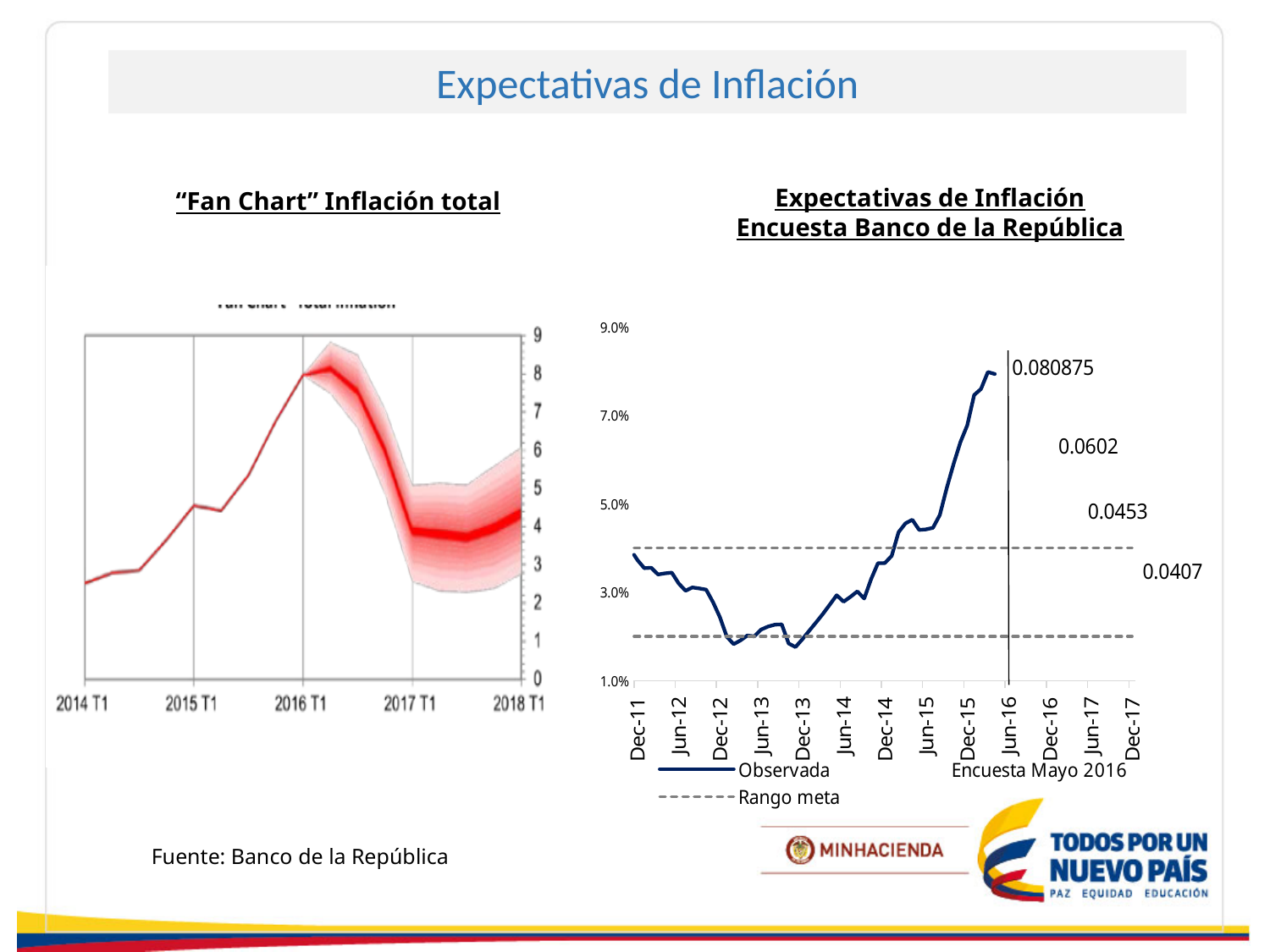
In the right chart (Encuesta Banco de la República), is the observed value at Dec-12 greater or less than 3.0%? less What kind of chart is the "Expectativas de Inflación Encuesta Banco de la República" chart on the right? line chart In the right chart (Encuesta Banco de la República), is the observed value at Dec-15 greater or less than 5.0%? greater In the right chart (Encuesta Banco de la República), do the survey expectation labels rise or fall from 0.080875 to 0.0407 moving right along the x axis? fall In the right chart (Encuesta Banco de la República), how many entries does the legend list? 3 In the right chart (Encuesta Banco de la República), what is the data label printed between 0.080875 and 0.0453? 0.0602 In the left "Fan Chart" Inflación total chart, is the value at 2016 T1 greater or less than 7? greater In the right chart (Encuesta Banco de la República), what is the data label printed at the peak of the observed line near Jun-16? 0.080875 In the right chart (Encuesta Banco de la República), what is the name of the dashed-line series in the legend? Rango meta In the left "Fan Chart" Inflación total chart, which of the two points is higher: 2016 T1 or 2017 T1? 2016 T1 In the right chart (Encuesta Banco de la República), what is the lowest data label printed on the survey expectations, at the far right? 0.0407